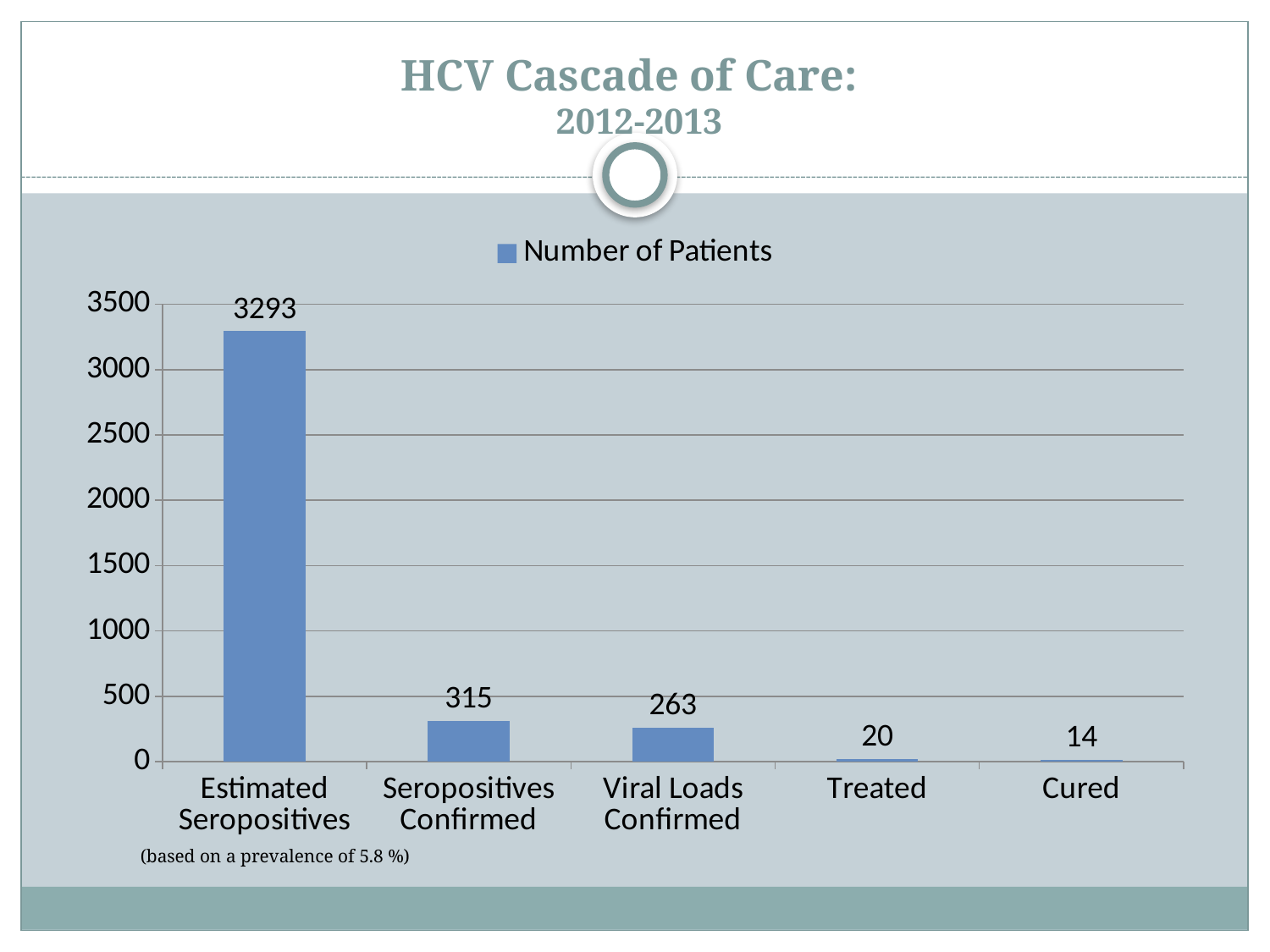
What is the number of patients Cured? 14 What series name does the legend show? Number of Patients Which category has the lowest number of patients? Cured What kind of chart is shown on the slide? Bar chart What is the number of patients for Seropositives Confirmed? 315 What is the number of patients for Estimated Seropositives? 3293 Which is larger, the number Treated or the number Cured? Treated What is the difference between Seropositives Confirmed and Viral Loads Confirmed? 52 What is the number of patients Treated? 20 How many categories are shown on the x axis? 5 Which category has the highest number of patients? Estimated Seropositives What is the number of patients for Viral Loads Confirmed? 263